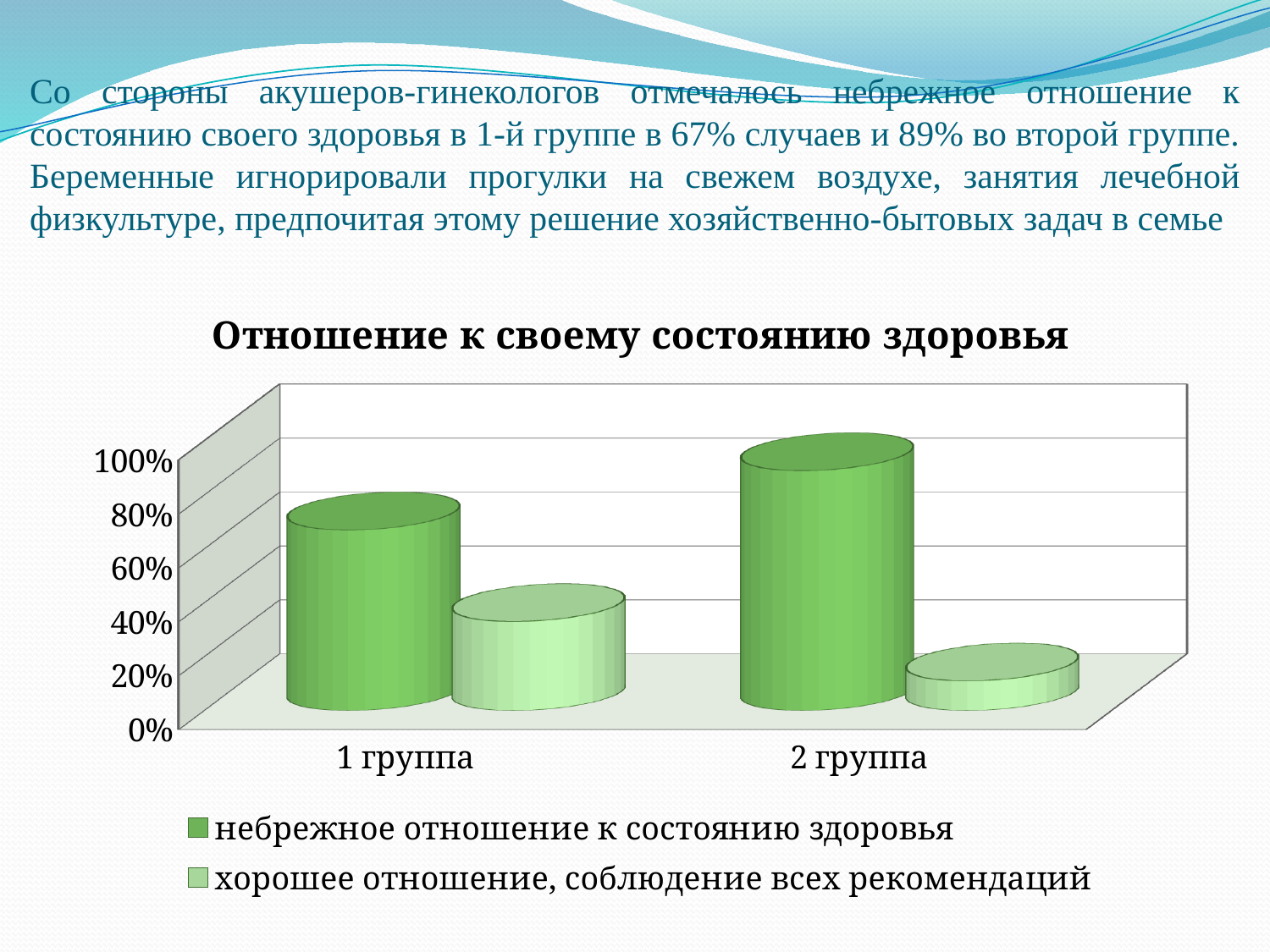
Which group has the higher value for 'хорошее отношение, соблюдение всех рекомендаций', 1 группа or 2 группа? 1 группа Does the value for 'небрежное отношение к состоянию здоровья' rise or fall from 1 группа to 2 группа? rise Is the value for 'хорошее отношение, соблюдение всех рекомендаций' in 1 группа greater or less than 60%? less What kind of chart is shown on the slide? bar chart Is the value for 'небрежное отношение к состоянию здоровья' in 1 группа greater or less than 60%? greater What is the title of the chart? Отношение к своему состоянию здоровья Which series is shown in the darker green colour? небрежное отношение к состоянию здоровья Is the value for 'хорошее отношение, соблюдение всех рекомендаций' in 2 группа greater or less than 40%? less Which group has the higher value for 'небрежное отношение к состоянию здоровья', 1 группа or 2 группа? 2 группа How many series does the legend list? 2 How many groups (categories) are shown on the x axis? 2